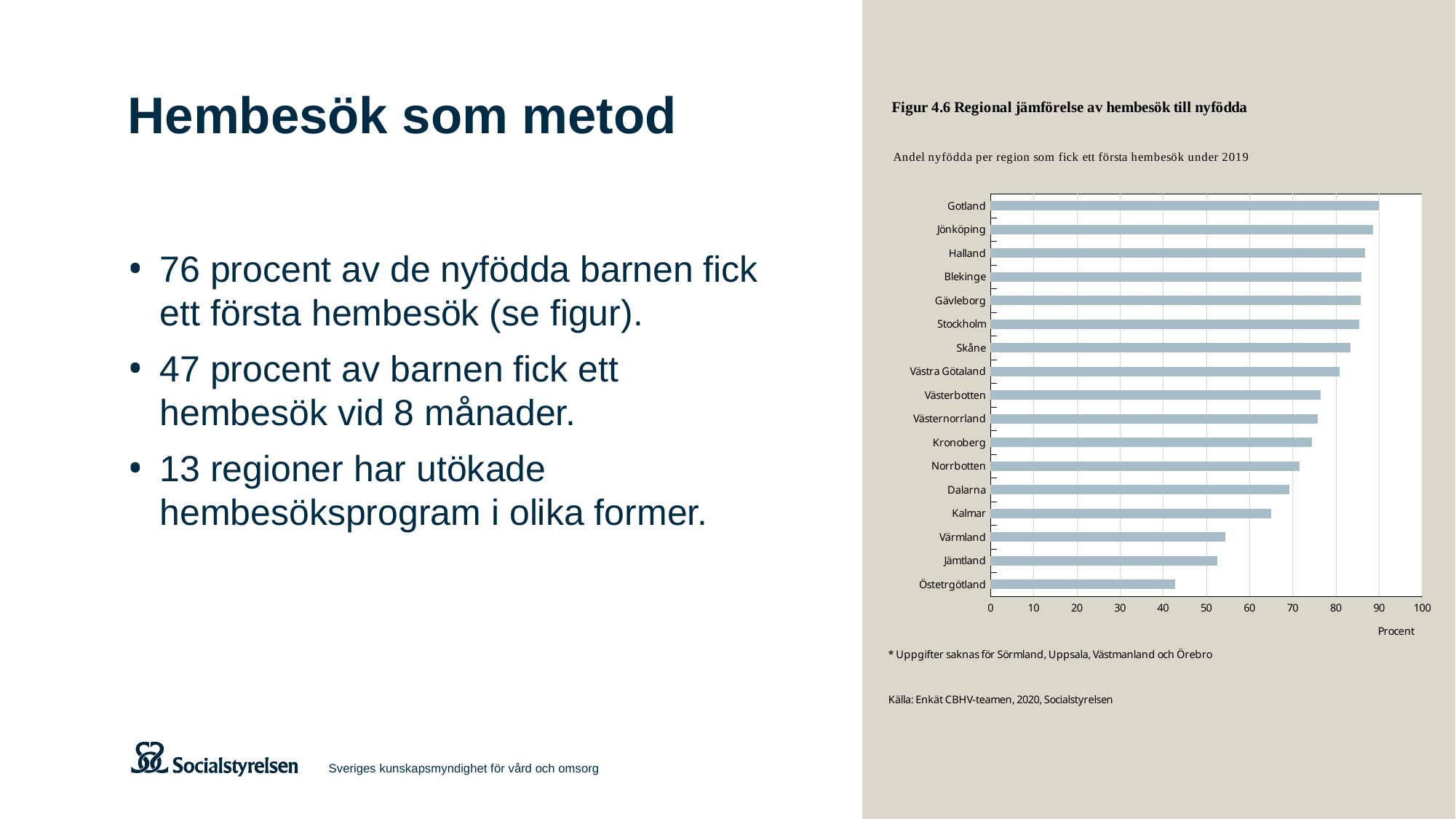
What is the title of the figure? Figur 4.6 Regional jämförelse av hembesök till nyfödda Is the value for Gotland greater or less than 80? greater Is the value for Västerbotten greater or less than 70? greater Which region has the lowest share of newborns receiving a first home visit? Östetrgötland Which has a larger value, Stockholm or Värmland? Stockholm Which region has the highest share of newborns receiving a first home visit? Gotland Is the value for Kalmar greater or less than 60? greater How many regions are plotted in the chart? 17 What kind of chart is shown on the slide? bar chart What unit is shown on the x axis of the chart? Procent